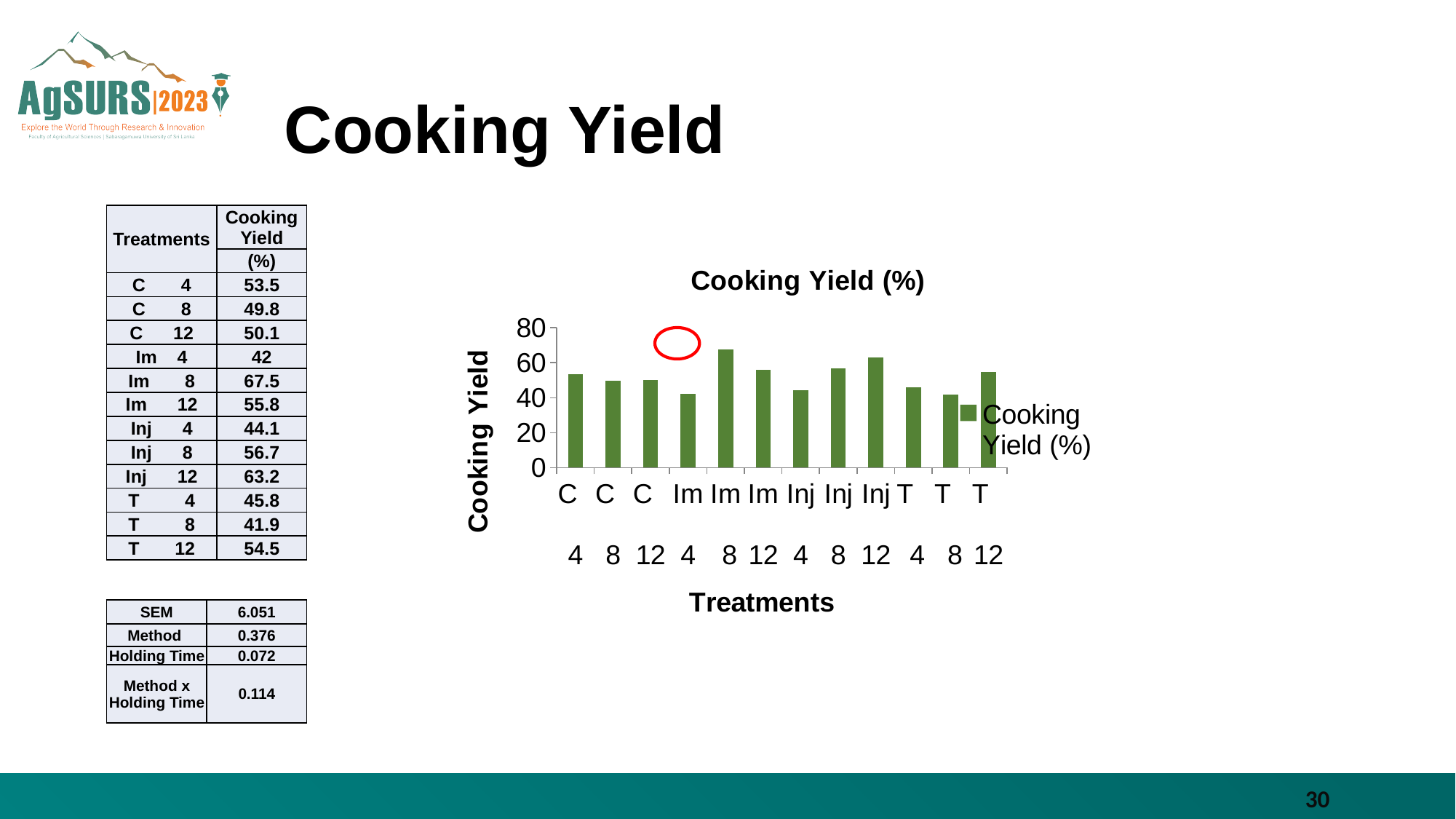
Which has the larger cooking yield, treatment Inj 12 or treatment T 4? Inj 12 Is the cooking yield for treatment Im 4 greater or less than 60? less Is the cooking yield for treatment T 8 greater or less than 60? less According to the table on the slide, what is the cooking yield (%) for treatment Im 8? 67.5 Is the cooking yield for treatment Im 8 greater or less than 60? greater What type of chart is shown on the slide? bar chart What is the label on the x axis of the chart? Treatments How many series does the legend of the chart list? 1 Which treatment has the highest cooking yield in the chart? Im 8 How many bars are plotted in the Cooking Yield (%) chart? 12 What is the title of the chart? Cooking Yield (%) Do the cooking yield bars for the Inj treatments rise or fall as holding time goes from 4 to 12? rise